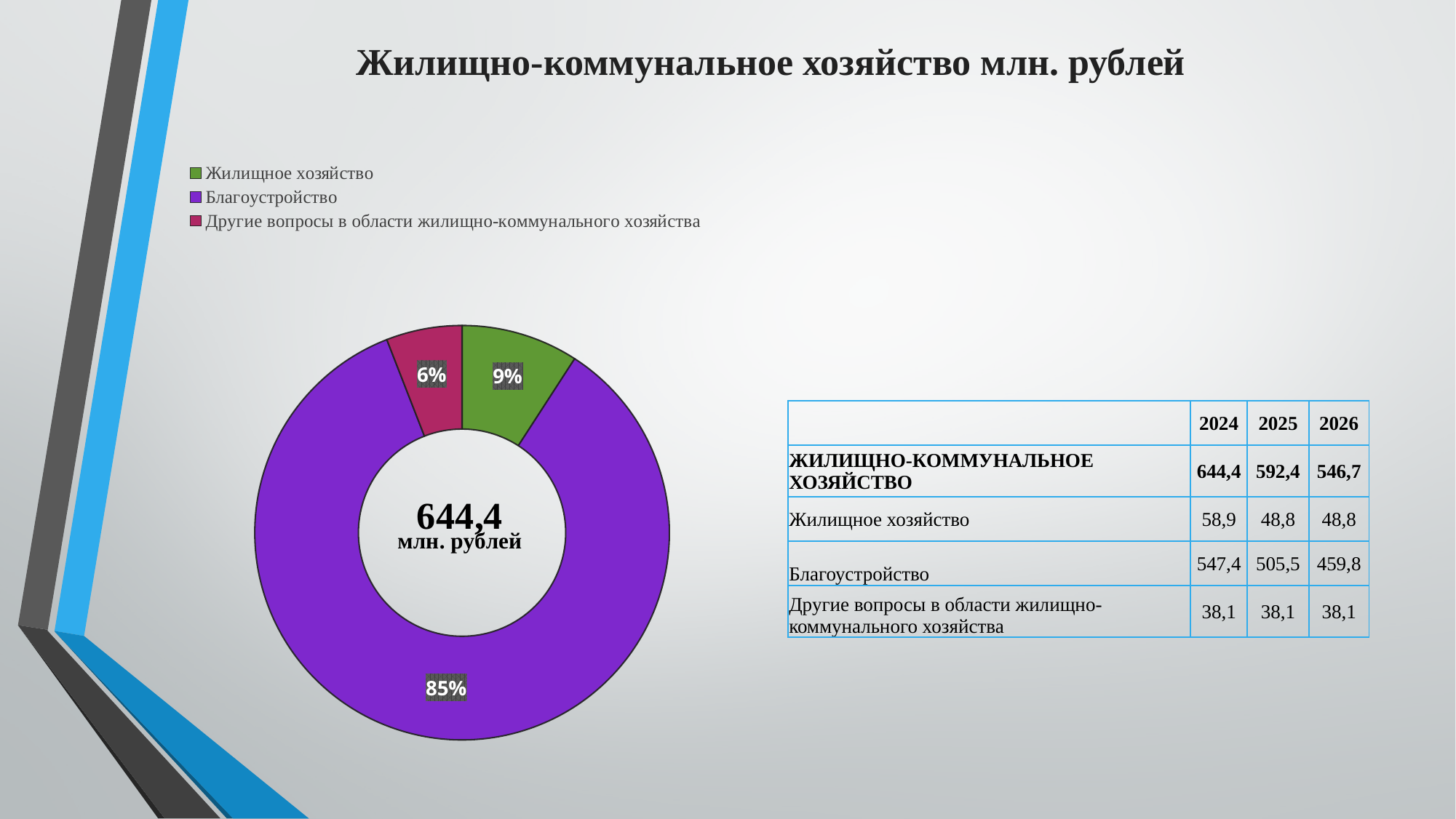
Which category has the smallest slice in the pie chart? Другие вопросы в области жилищно-коммунального хозяйства How many entries does the legend of the pie chart list? 3 How many slices does the pie chart have? 3 What colour is the Благоустройство slice in the pie chart? Purple What kind of chart is shown on the slide? Pie chart (donut) What total value is printed in the centre of the donut chart? 644,4 млн. рублей What share of the pie chart does Жилищное хозяйство take? 9% Which category has the largest slice in the pie chart? Благоустройство Which slice is larger in the pie chart: Жилищное хозяйство or Другие вопросы в области жилищно-коммунального хозяйства? Жилищное хозяйство What share of the pie chart does Другие вопросы в области жилищно-коммунального хозяйства take? 6% What share of the pie chart does Благоустройство take? 85% What is the difference in percentage points between the Благоустройство slice and the Жилищное хозяйство slice? 76 percentage points